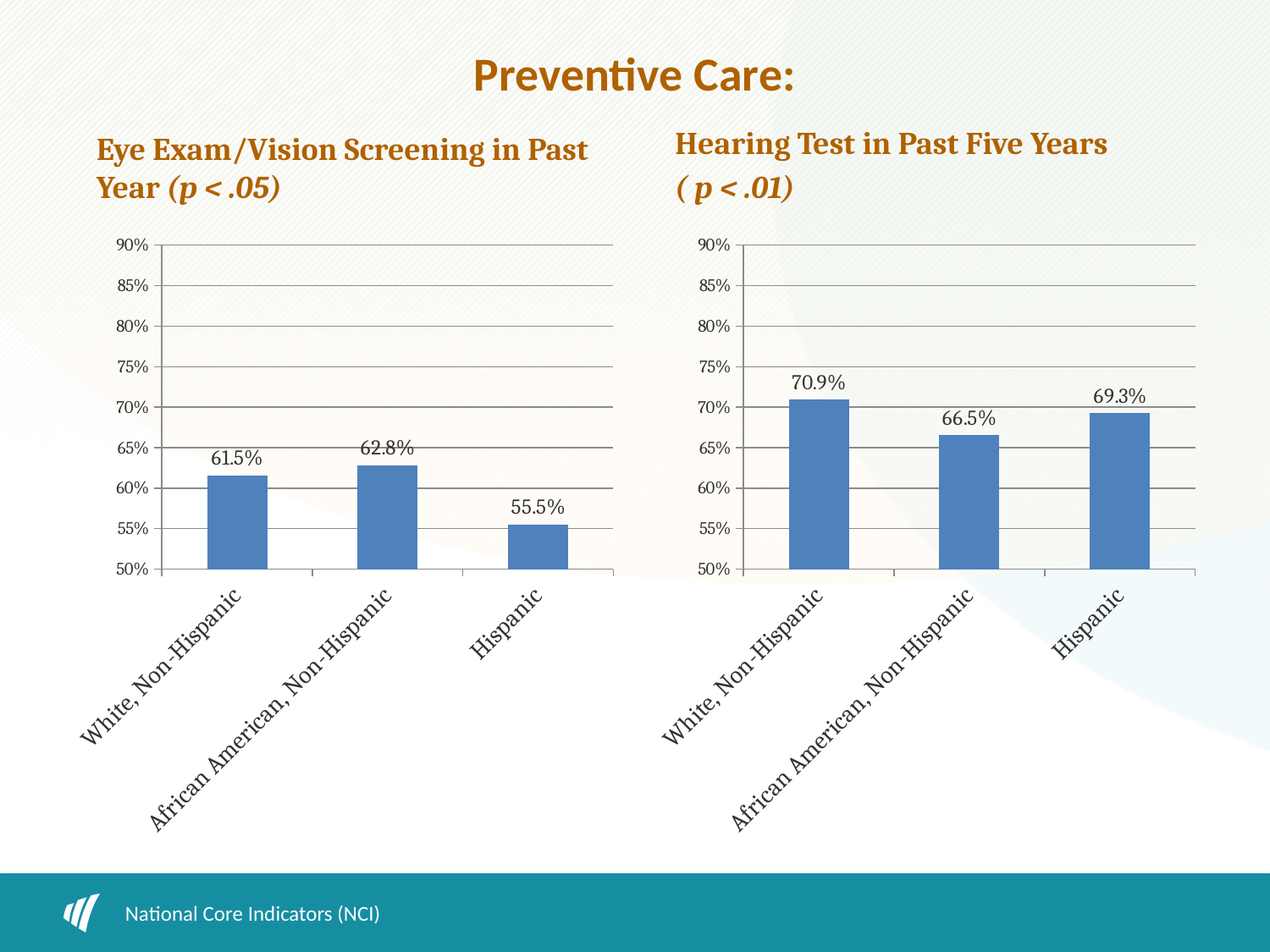
In the Eye Exam/Vision Screening in Past Year chart, what is the value for White, Non-Hispanic? 61.5% In the Hearing Test in Past Five Years chart, what is the difference between the White, Non-Hispanic value and the Hispanic value? 1.6% In the Hearing Test in Past Five Years chart, which category has the lowest value? African American, Non-Hispanic In the Hearing Test in Past Five Years chart, which is larger: the value for White, Non-Hispanic or the value for African American, Non-Hispanic? White, Non-Hispanic In the Eye Exam/Vision Screening in Past Year chart, is the value for Hispanic greater or less than 60%? less In the Hearing Test in Past Five Years chart, what is the value for White, Non-Hispanic? 70.9% In the Hearing Test in Past Five Years chart, what is the value for African American, Non-Hispanic? 66.5% In the Eye Exam/Vision Screening in Past Year chart, what is the difference between the African American, Non-Hispanic value and the Hispanic value? 7.3% In the Eye Exam/Vision Screening in Past Year chart, which category has the highest value? African American, Non-Hispanic How many categories are shown in the Hearing Test in Past Five Years chart? 3 In the Eye Exam/Vision Screening in Past Year chart, what is the value for Hispanic? 55.5% What kind of chart is the Eye Exam/Vision Screening in Past Year chart? bar chart